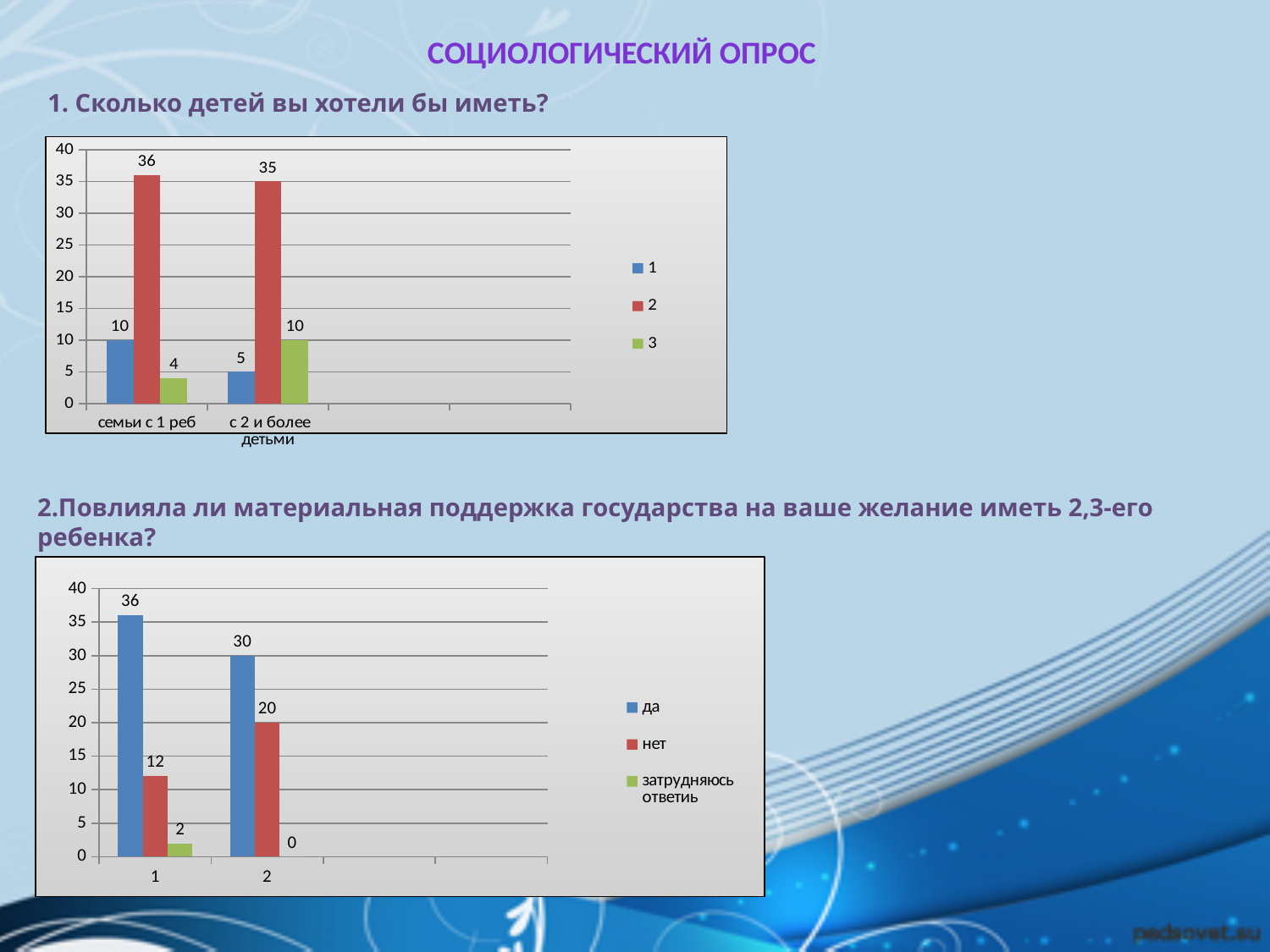
In the top chart, what is the difference between series 2 and series 1 for 'с 2 и более детьми'? 30 In the top chart, how many series does the legend list? 3 In the bottom chart, how many categories are shown on the x axis? 2 In the bottom chart, which is larger for category 2: 'да' or 'нет'? да In the top chart, what is the value of series 3 for 'с 2 и более детьми'? 10 In the top chart, which series has the lowest value for 'семьи с 1 реб'? 3 In the bottom chart, what colour are the 'нет' bars? red In the top chart, what is the value of series 2 for 'семьи с 1 реб'? 36 In the bottom chart, what is the value of 'да' for category 1? 36 In the bottom chart, what is the difference between 'да' and 'нет' for category 1? 24 In the bottom chart, what is the value of 'затрудняюсь ответить' for category 2? 0 What type of chart is the top chart? bar chart